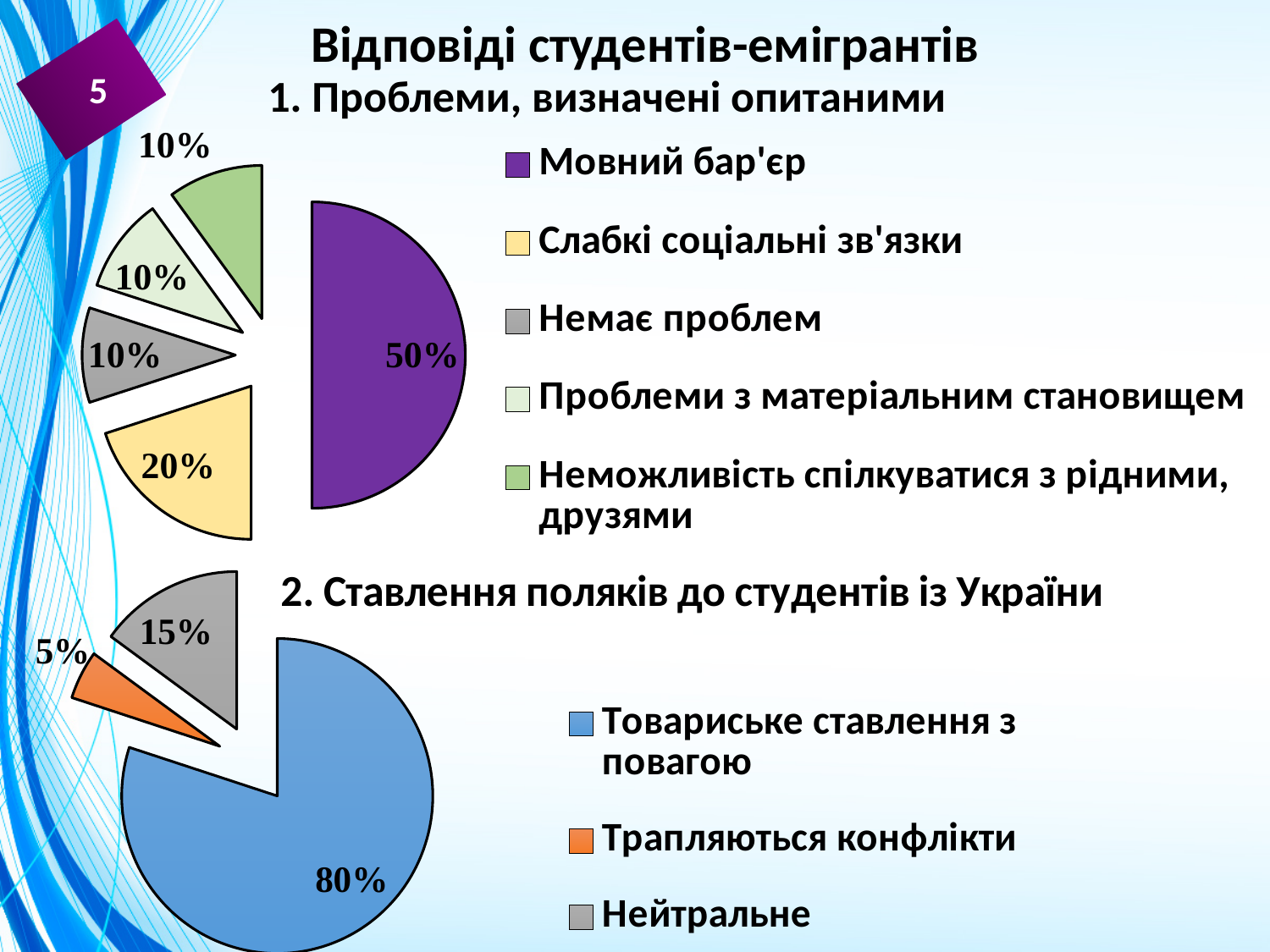
In the chart '2. Ставлення поляків до студентів із України', what share is labelled for 'Товариське ставлення з повагою'? 80% In the chart '2. Ставлення поляків до студентів із України', which is larger: 'Нейтральне' or 'Трапляються конфлікти'? Нейтральне In the chart '1. Проблеми, визначені опитаними', what share is labelled for 'Слабкі соціальні зв'язки'? 20% In the chart '1. Проблеми, визначені опитаними', what share is labelled for 'Мовний бар'єр'? 50% In the chart '2. Ставлення поляків до студентів із України', what share is labelled for 'Нейтральне'? 15% In the chart '2. Ставлення поляків до студентів із України', which category has the smallest slice? Трапляються конфлікти In the chart '2. Ставлення поляків до студентів із України', what colour is the slice for 'Товариське ставлення з повагою'? Blue In the chart '1. Проблеми, визначені опитаними', how many categories does the legend list? 5 What kind of chart is used for '1. Проблеми, визначені опитаними'? Pie chart In the chart '1. Проблеми, визначені опитаними', what is the difference between the shares for 'Мовний бар'єр' and 'Слабкі соціальні зв'язки'? 30% In the chart '2. Ставлення поляків до студентів із України', what share is labelled for 'Трапляються конфлікти'? 5% In the chart '1. Проблеми, визначені опитаними', which category has the largest slice? Мовний бар'єр